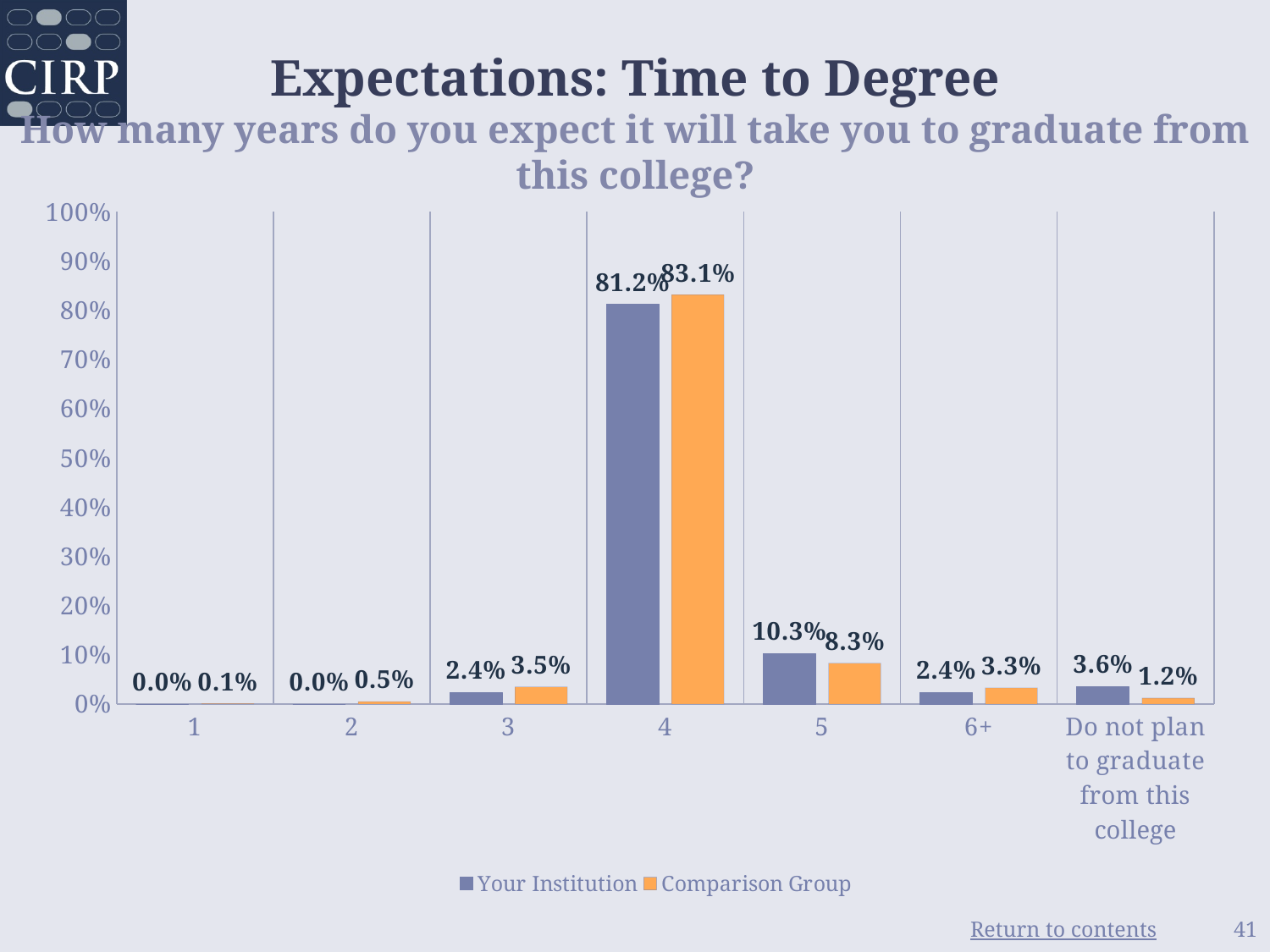
What is the value for Comparison Group in the 5 years category? 8.3% Which category has the lowest value for Comparison Group? 1 Which is larger in the 5 years category, Your Institution or Comparison Group? Your Institution Is the value for Your Institution in the 4 years category greater or less than 80%? greater How many series does the legend list? 2 Which category has the highest value for Comparison Group? 4 What is the title of the chart? How many years do you expect it will take you to graduate from this college? What is the difference between Comparison Group and Your Institution in the 4 years category? 1.9% What is the value for Your Institution in the 4 years category? 81.2% What kind of chart is shown on the slide? bar chart How many categories are shown on the x axis? 7 What is the value for Your Institution in the 'Do not plan to graduate from this college' category? 3.6%